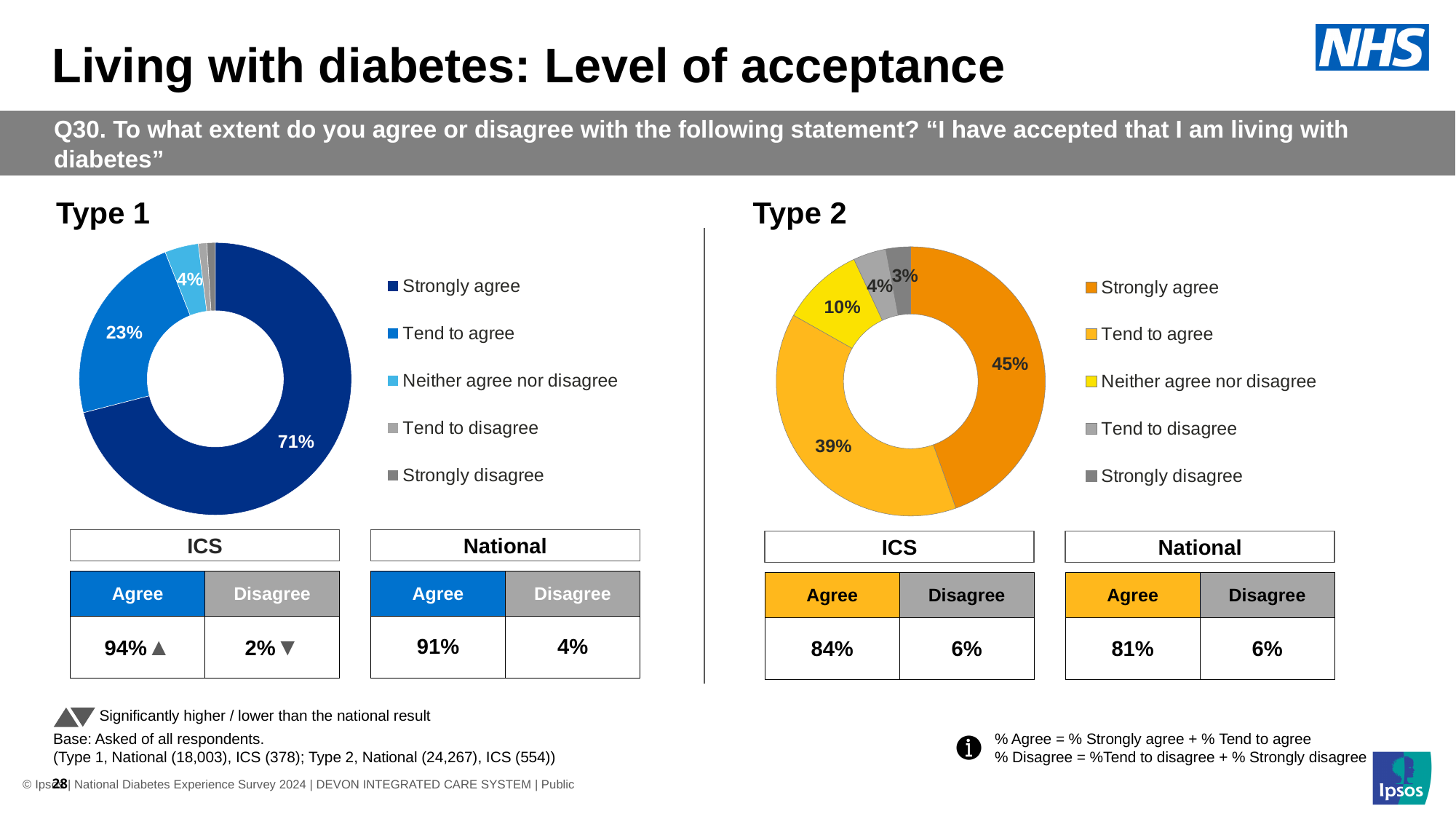
In the Type 1 chart, which response category has the largest share? Strongly agree In the Type 2 chart, what is the difference between the strongly agree and tend to agree shares? 6% In the Type 2 chart, what percentage of respondents said they strongly disagree? 3% Which chart shows a larger share for strongly agree, Type 1 or Type 2? Type 1 In the Type 1 chart, what percentage of respondents said they tend to agree? 23% In the Type 2 chart, which labelled response category has the smallest share? Strongly disagree How many response categories does the legend of the Type 2 chart list? 5 In the Type 1 chart, what percentage of respondents said they strongly agree? 71% In the Type 2 chart, what percentage of respondents said they strongly agree? 45% In the Type 2 chart, what percentage of respondents said they neither agree nor disagree? 10% In the Type 1 chart, what colour represents the strongly agree category? Dark blue What kind of chart is used to show the Type 1 results? Donut chart